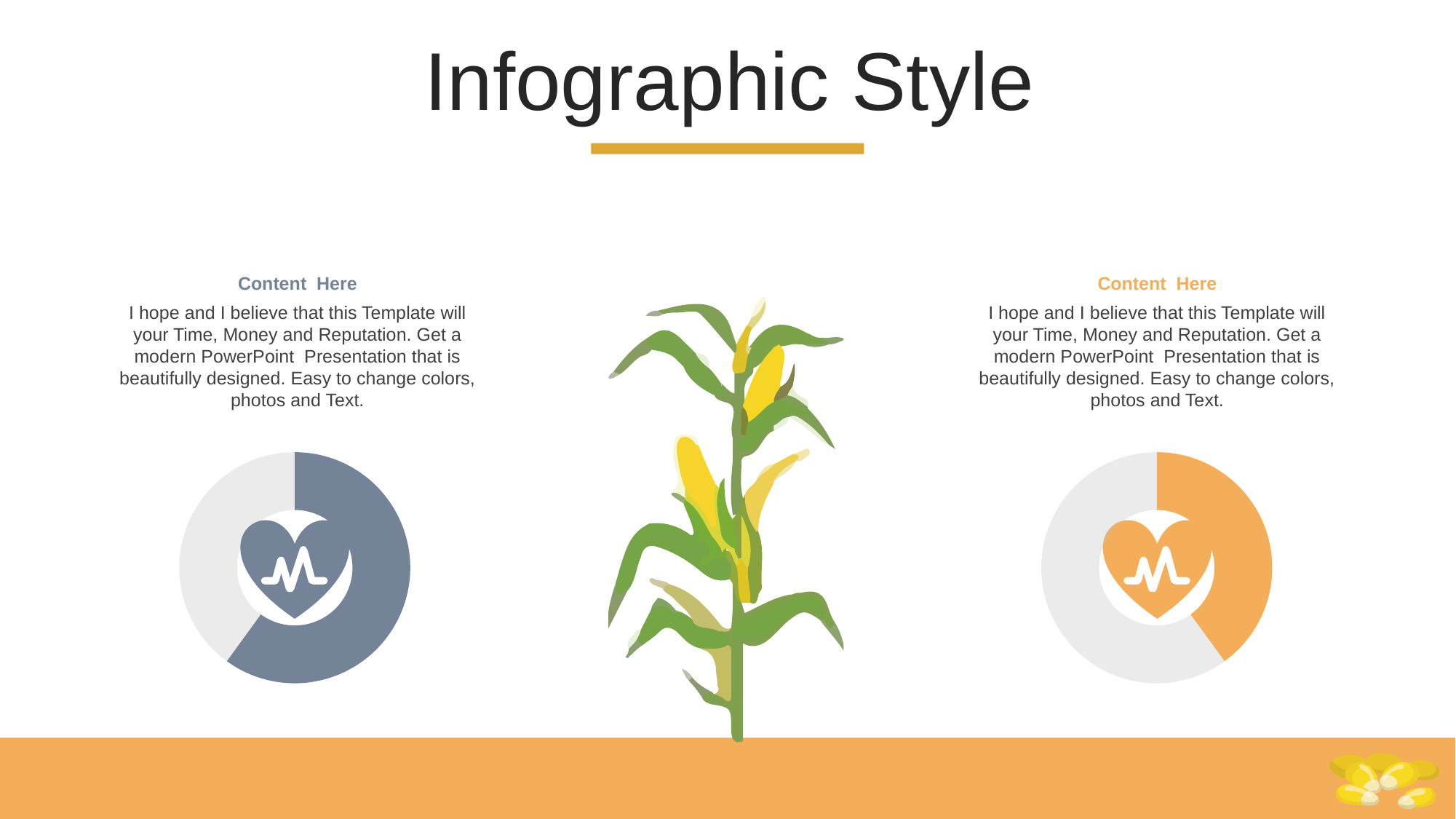
What colour is the highlighted slice in the pie chart on the right side of the slide? orange What kind of chart is shown on the left side of the slide? doughnut chart What kind of chart is shown on the right side of the slide? doughnut chart How many pie charts are on the slide? 2 How many slices does the pie chart on the right side of the slide have? 2 In the pie chart on the left side of the slide, which slice is larger, the blue-grey slice or the light grey slice? the blue-grey slice How many slices does the pie chart on the left side of the slide have? 2